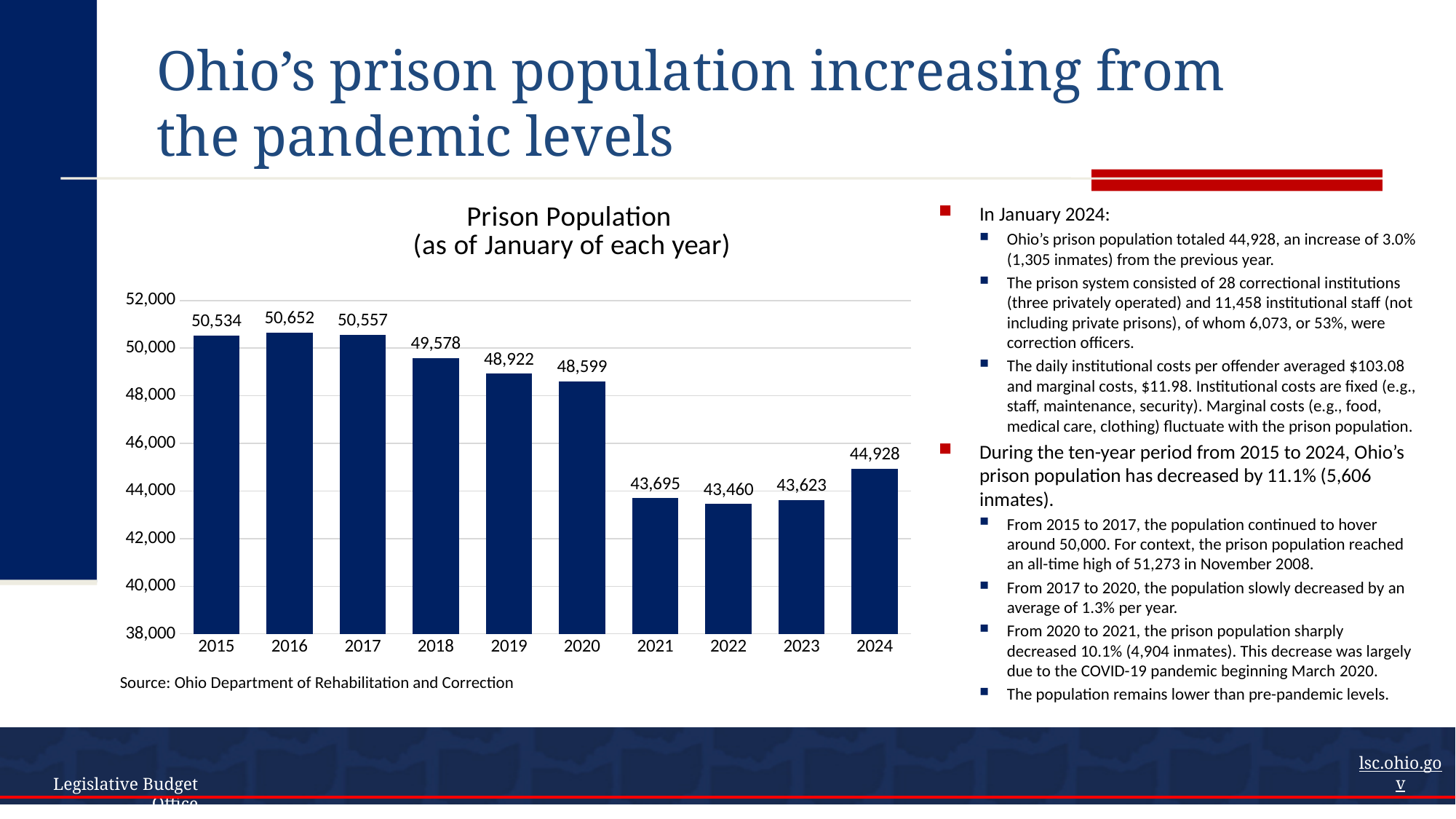
How many years are shown on the x axis of the chart? 10 Which year has the highest prison population in the chart? 2016 Which year has the lowest prison population in the chart? 2022 What is the title of the chart? Prison Population (as of January of each year) Does the prison population rise or fall from 2017 to 2020? fall What was the prison population in January 2022? 43,460 What is the difference between the prison population in 2024 and in 2023? 1,305 What kind of chart is used to show the prison population? bar chart What is the difference between the prison population in 2020 and in 2021? 4,904 Which year had a larger prison population, 2019 or 2024? 2019 What was the prison population in January 2018? 49,578 Is the prison population for 2021 greater or less than 44,000? less